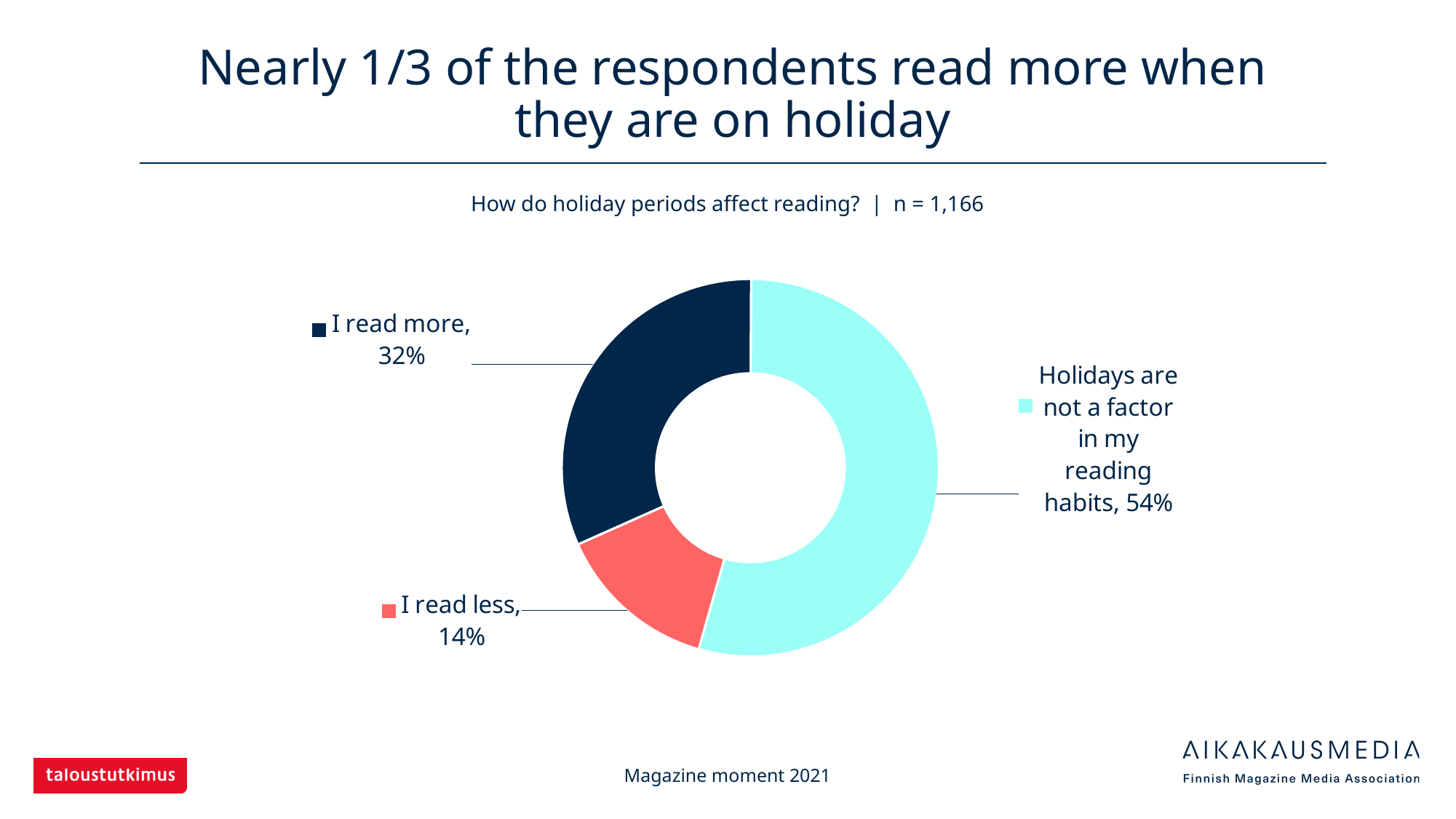
What is the sample size (n) stated for the chart? 1,166 What question does the chart subtitle say the data answers? How do holiday periods affect reading? What is the difference in percentage points between 'I read more' and 'I read less'? 18 How many categories are shown in the chart? 3 What share of respondents said they read less on holiday? 14% Which response has the largest share of the chart? Holidays are not a factor in my reading habits What share of respondents said holidays are not a factor in their reading habits? 54% What is the difference in percentage points between 'Holidays are not a factor in my reading habits' and 'I read more'? 22 Which response has the smallest share of the chart? I read less What kind of chart is shown on the slide? Doughnut (pie) chart What share of respondents said they read more on holiday? 32% Which is larger: the share for 'I read more' or the share for 'I read less'? I read more